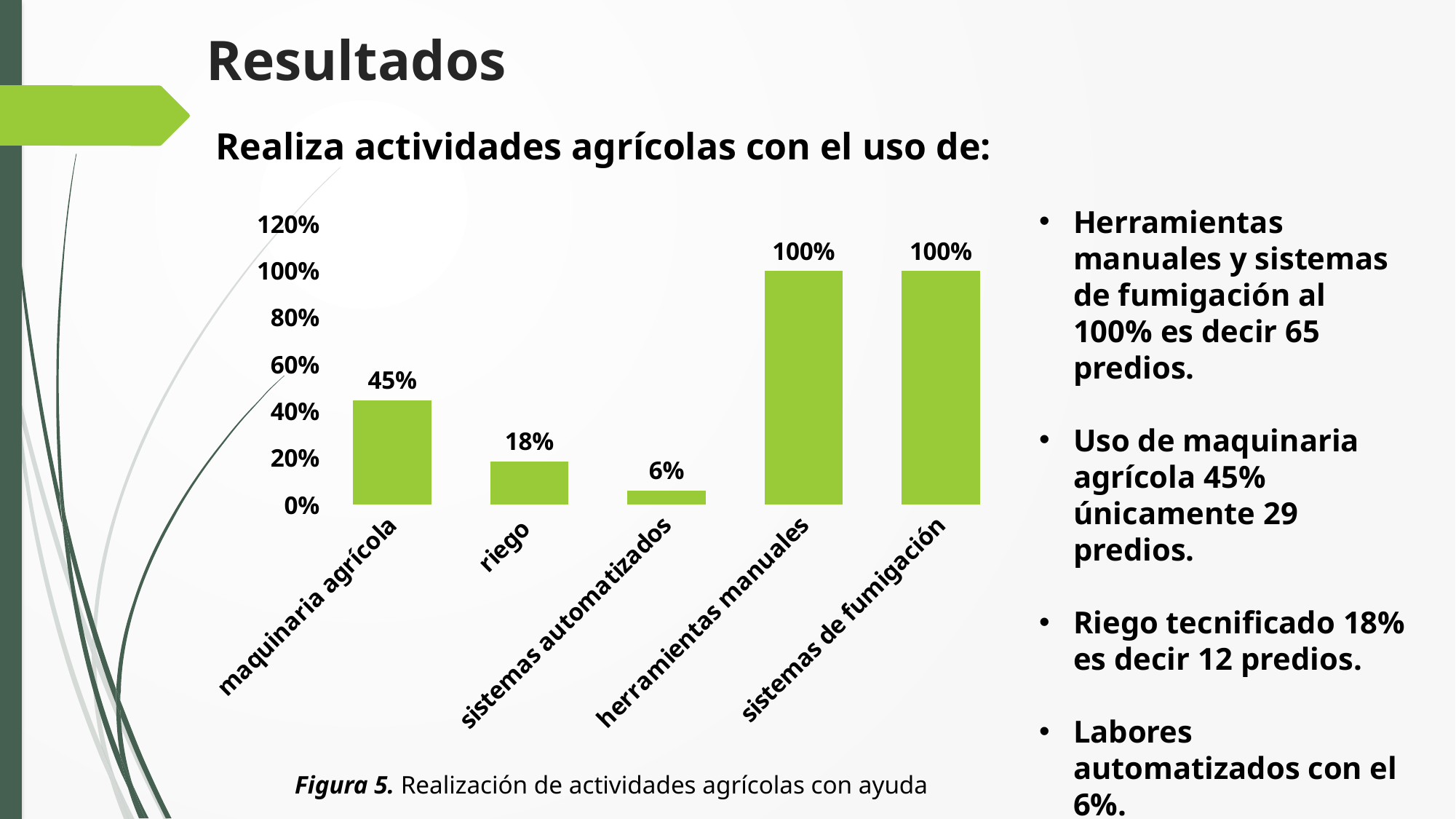
What is the difference between the values for maquinaria agrícola and riego? 27% Which is larger, the value for riego or the value for sistemas automatizados? riego What kind of chart is shown on the slide? bar chart How many categories are shown on the x axis? 5 What is the highest value shown on the y axis? 120% What is the difference between the values for herramientas manuales and maquinaria agrícola? 55% Is the value for maquinaria agrícola greater or less than 40%? greater What is the value for herramientas manuales? 100% What is the value for riego? 18% Which category has the lowest value? sistemas automatizados What is the value for maquinaria agrícola? 45% What is the value for sistemas automatizados? 6%